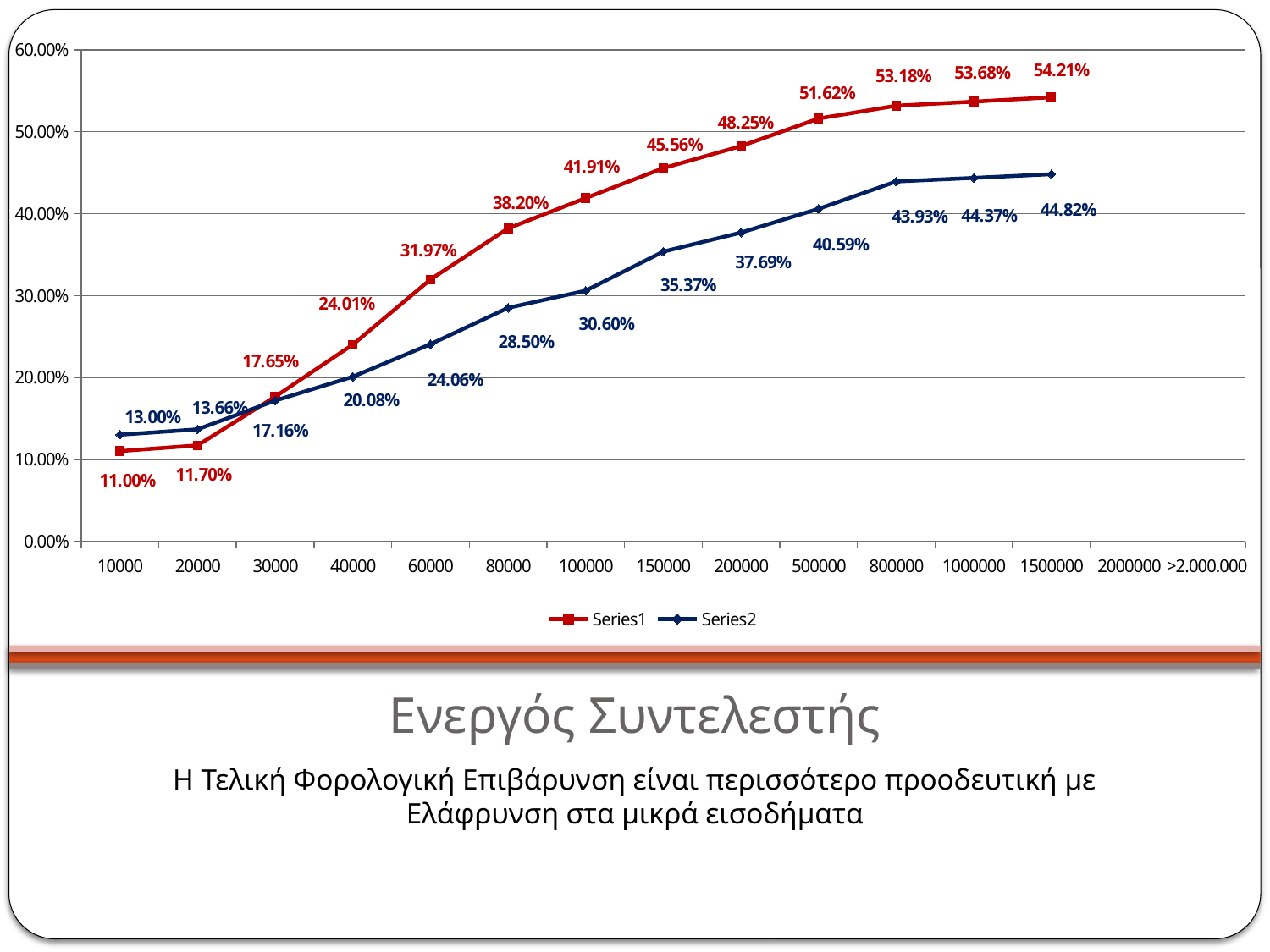
What is the difference between Series1 and Series2 at 1500000? 9.39 percentage points At 10000, which series has the larger value, Series1 or Series2? Series2 By how much does Series1 increase from 10000 to 20000? 0.70 percentage points What kind of chart is shown on the slide? Line chart Is the value of Series1 at 800000 greater or less than 50.00%? greater What is the value of Series2 at 100000? 30.60% Do the values of Series1 rise or fall as you move along the x axis from 10000 to 1500000? Rise At which x-axis category does Series1 reach its highest value? 1500000 At 40000, which series has the larger value, Series1 or Series2? Series1 At which x-axis category is Series2 at its lowest value? 10000 What is the value of Series1 at 60000? 31.97% How many series does the legend list? 2